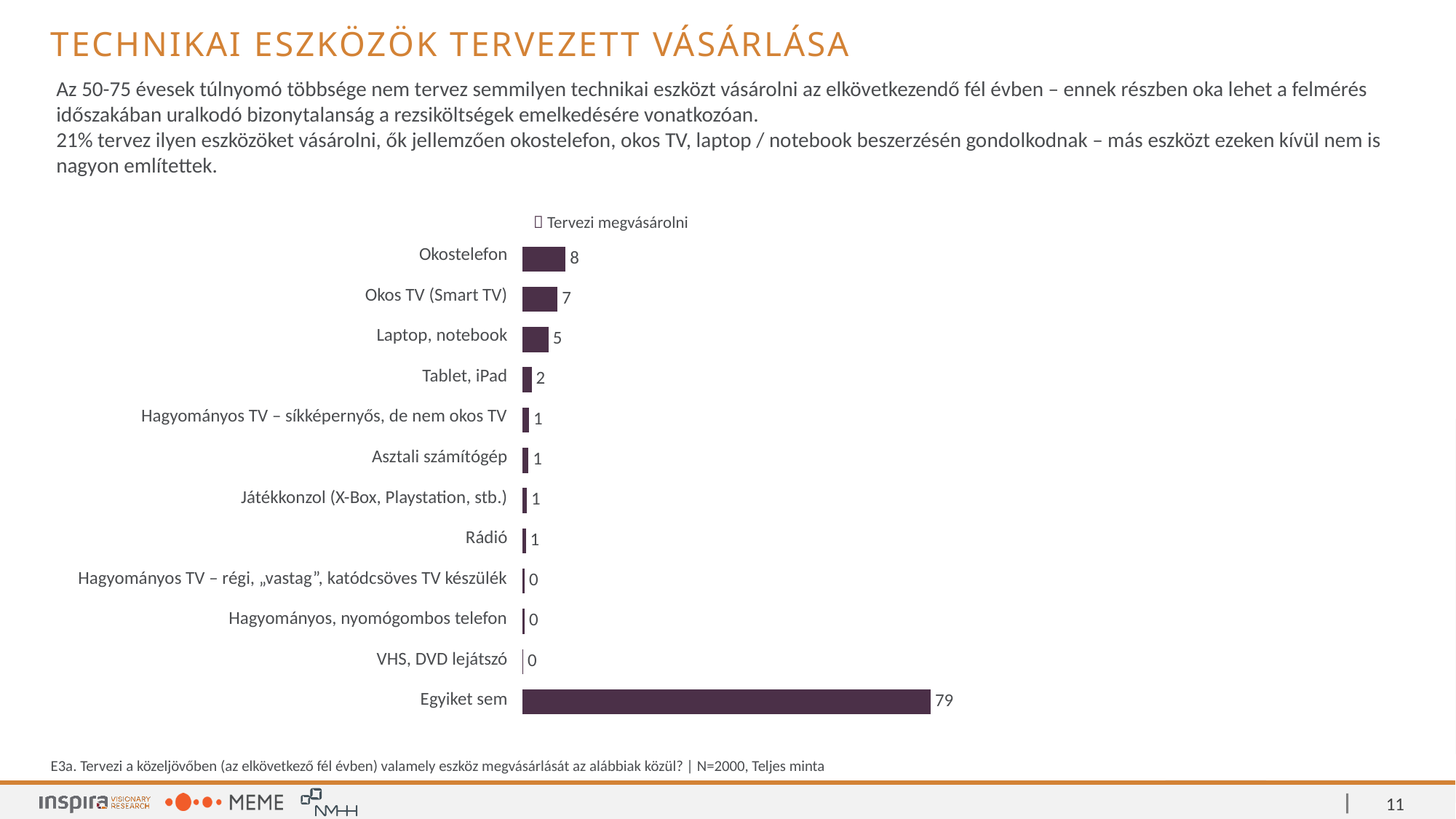
What is the value for Tablet, iPad? 2 Which is larger, the value for Okos TV (Smart TV) or the value for Laptop, notebook? Okos TV (Smart TV) What is the legend entry of the chart? Tervezi megvásárolni What is the difference between the values for Okostelefon and Okos TV (Smart TV)? 1 What is the value for Egyiket sem? 79 How many categories are shown in the chart? 12 What is the value for Okostelefon? 8 What is the difference between the values for Egyiket sem and Okostelefon? 71 How many series does the legend list? 1 Which category has the highest value? Egyiket sem What is the value for Laptop, notebook? 5 What kind of chart is shown on the slide? bar chart